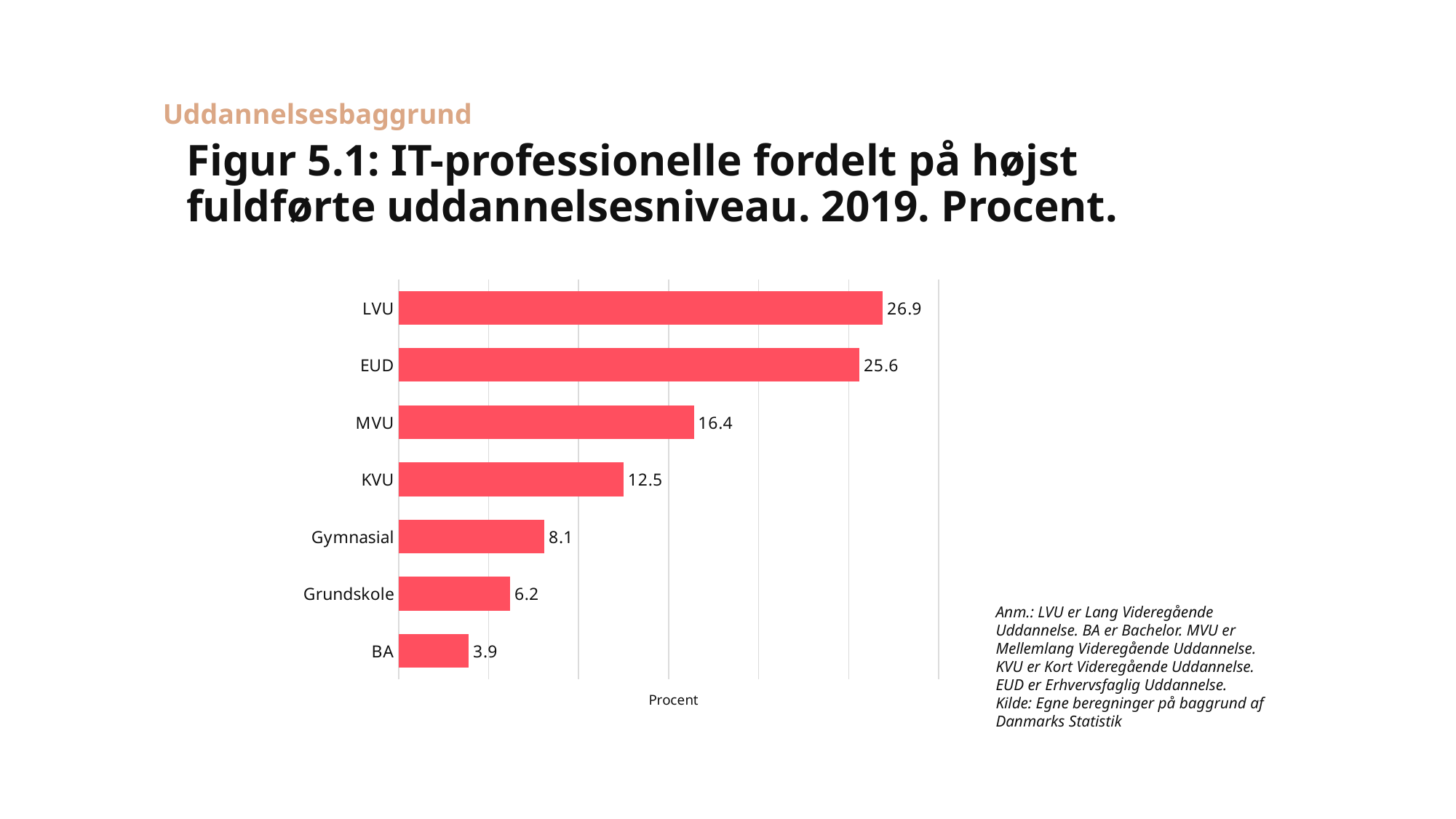
What is the label on the horizontal axis of the chart? Procent What is the value for MVU? 16.4 How many categories are shown in the chart? 7 What is the difference between the values for MVU and KVU? 3.9 Which category has the highest value? LVU What is the value for Gymnasial? 8.1 Which is larger, the value for Grundskole or the value for Gymnasial? Gymnasial What is the value for BA? 3.9 What kind of chart is shown on the slide? Bar chart Which category has the lowest value? BA What is the value for LVU? 26.9 What is the value for EUD? 25.6